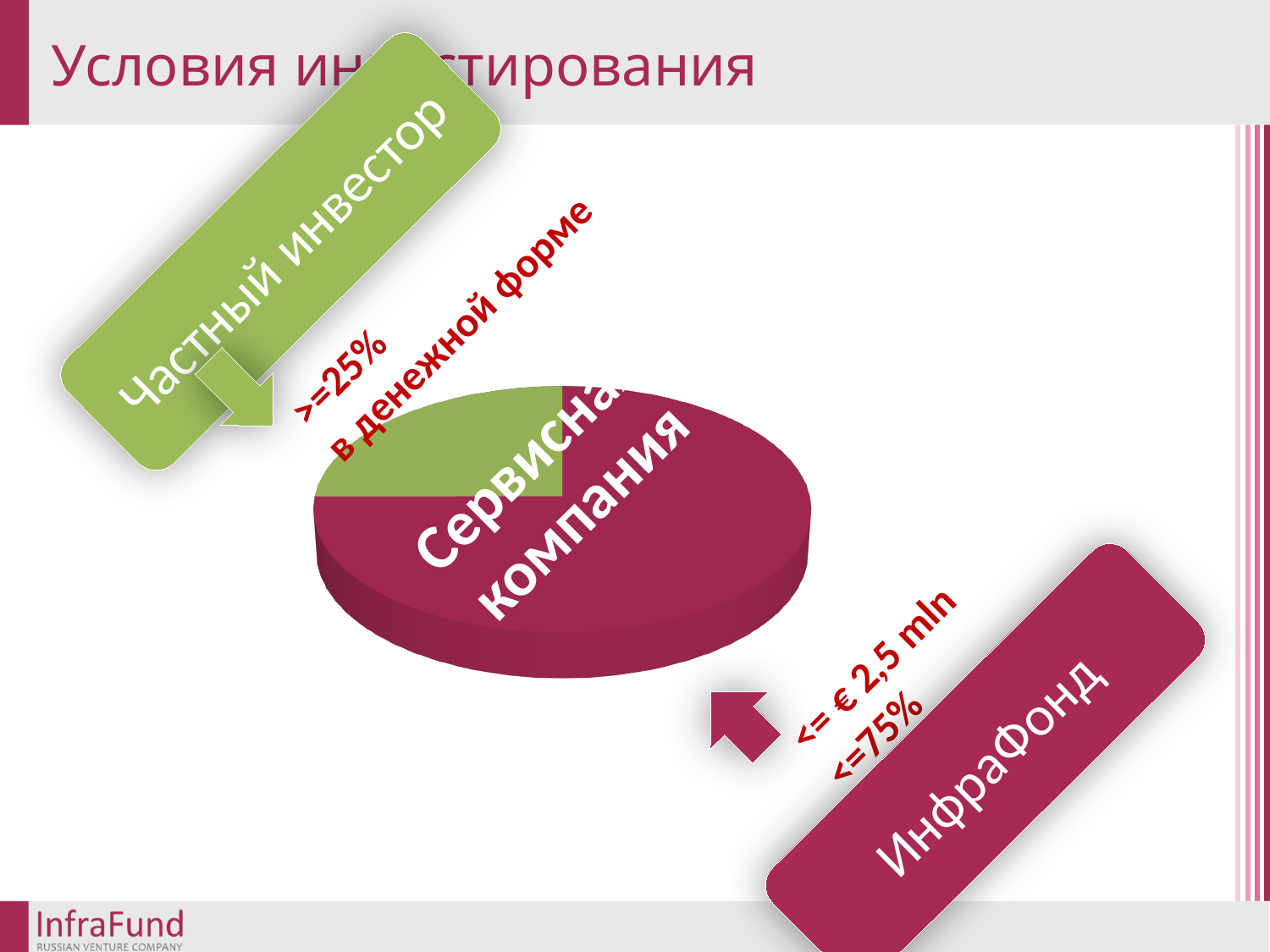
What kind of chart is shown on the slide? pie chart What maximum amount in euros is written next to the ИнфраФонд arrow? <= € 2,5 mln Is the magenta slice's share of the pie greater or less than 50%? greater Which investor's slice is the smallest in the pie chart, Частный инвестор or ИнфраФонд? Частный инвестор Is the green slice's share of the pie greater or less than 50%? less How many slices does the pie chart have? 2 Which investor's slice is the largest in the pie chart, Частный инвестор or ИнфраФонд? ИнфраФонд Which slice of the pie chart is larger, the green one or the magenta one? the magenta one What percentage condition is written next to the Частный инвестор arrow? >=25%